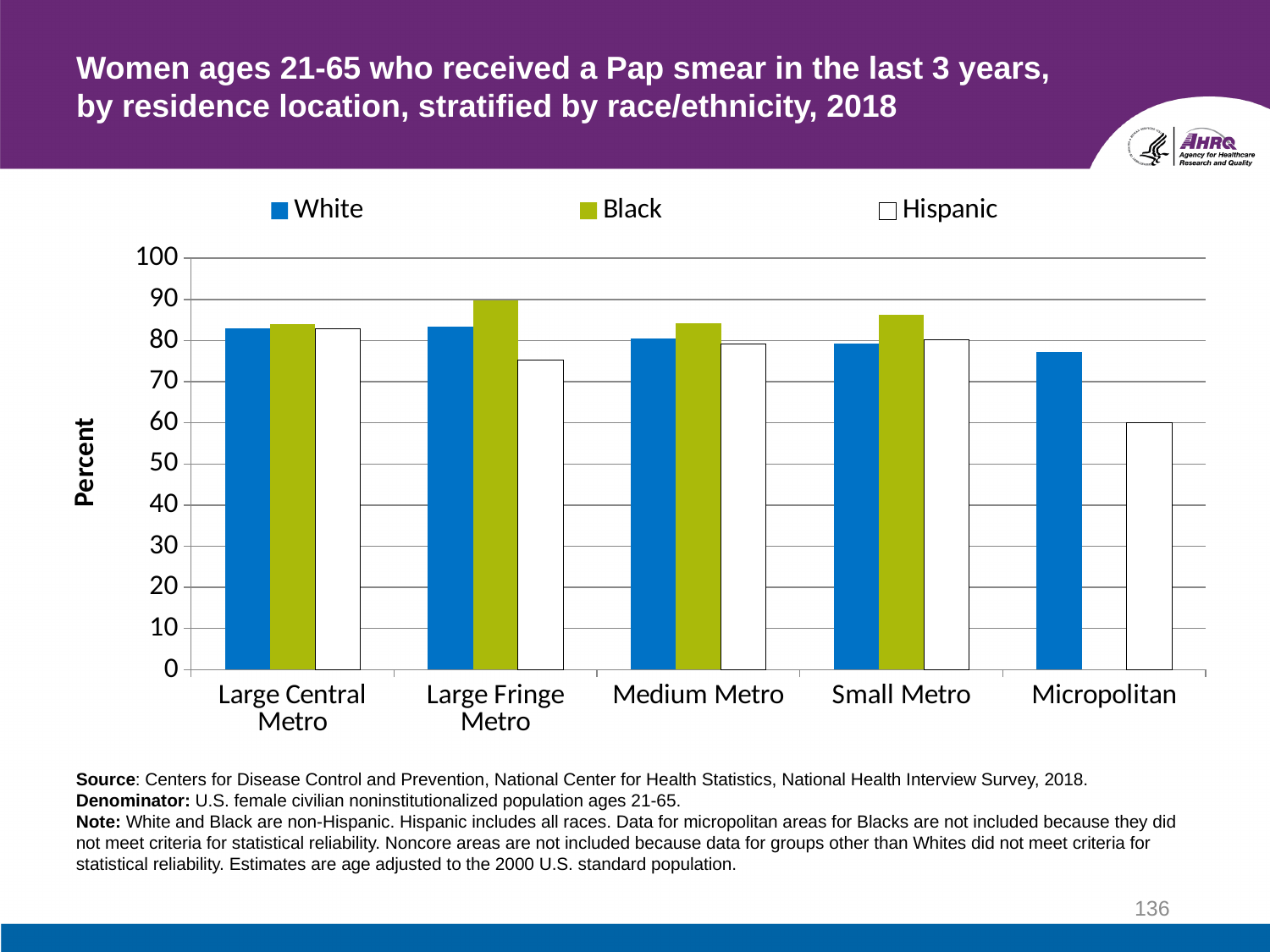
How many residence location categories are shown on the x axis? 5 In Micropolitan, which is larger, the value for White or the value for Hispanic? White Which residence location has the highest value for Black? Large Fringe Metro What kind of chart is shown on the slide? bar chart Which residence location category has no bar for Black? Micropolitan Which residence location has the lowest value for White? Micropolitan Which residence location has the lowest value for Hispanic? Micropolitan In Large Fringe Metro, which is larger, the value for Black or the value for Hispanic? Black How many series does the legend list? 3 Is the value for Black in Large Fringe Metro greater or less than 85? greater Is the value for Hispanic in Micropolitan greater or less than 70? less Is the value for White in Micropolitan greater or less than 70? greater